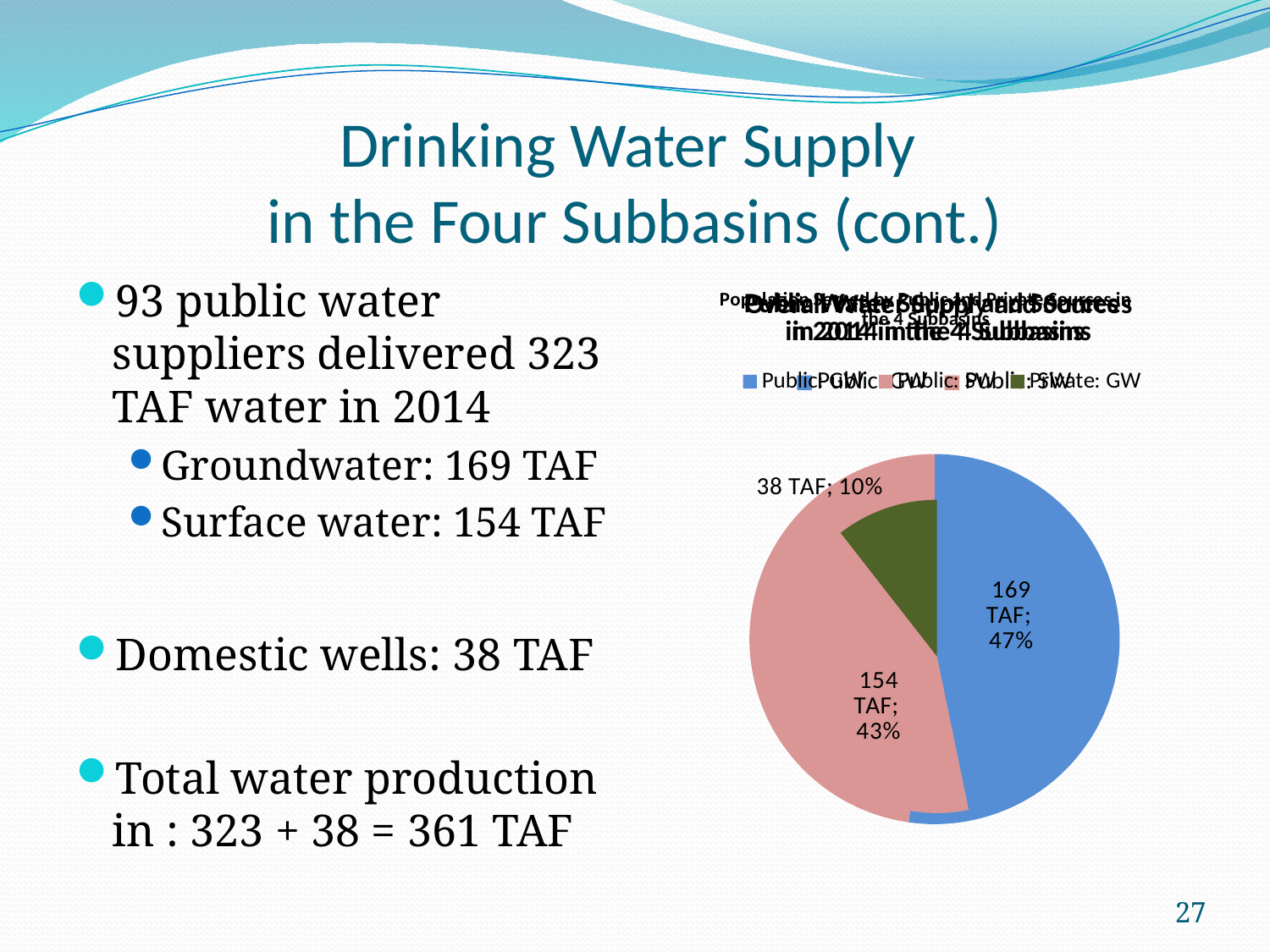
What is the difference in TAF between the 154 TAF slice and the 38 TAF slice? 116 TAF What percentage share is labelled on the smallest slice of the pie chart? 10% What is the difference in TAF between the 169 TAF slice and the 154 TAF slice? 15 TAF What value is labelled on the largest slice of the pie chart? 169 TAF What percentage share is labelled on the largest slice of the pie chart? 47% How many slices does the pie chart have? 3 What kind of chart is shown on the slide? pie chart What percentage share is labelled on the pink slice of the pie chart? 43% Which slice is larger, the blue slice or the pink slice? the blue slice What is the total of the three slice values in the pie chart? 361 TAF What colour is the slice labelled 38 TAF; 10%? green What value is labelled on the smallest slice of the pie chart? 38 TAF